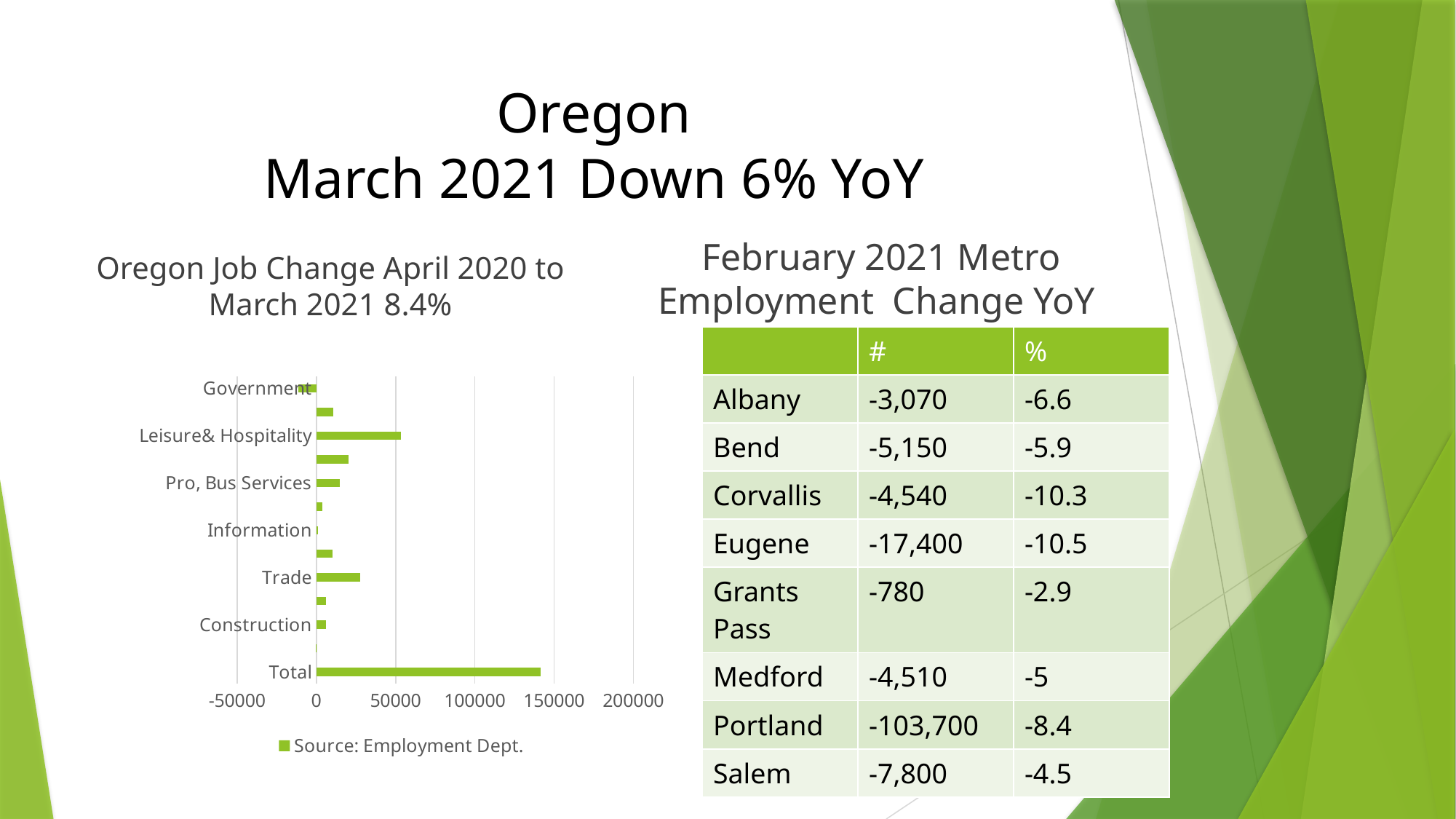
What kind of chart is shown on the slide? bar chart What is the title of the chart on the slide? Oregon Job Change April 2020 to March 2021 8.4% How many series does the chart's legend list? 1 Which category has the longest bar in the chart? Total Which is larger, the value for Trade or the value for Construction? Trade Which is larger, the value for Leisure& Hospitality or the value for Trade? Leisure& Hospitality Is the value for Trade greater or less than 50000? less What is the legend entry shown below the chart? Source: Employment Dept. Is the value for Total greater or less than 150000? less Which labeled category has the shortest bar in the chart? Information Excluding Total, which labeled category has the longest bar? Leisure& Hospitality Is the value for Total greater or less than 100000? greater